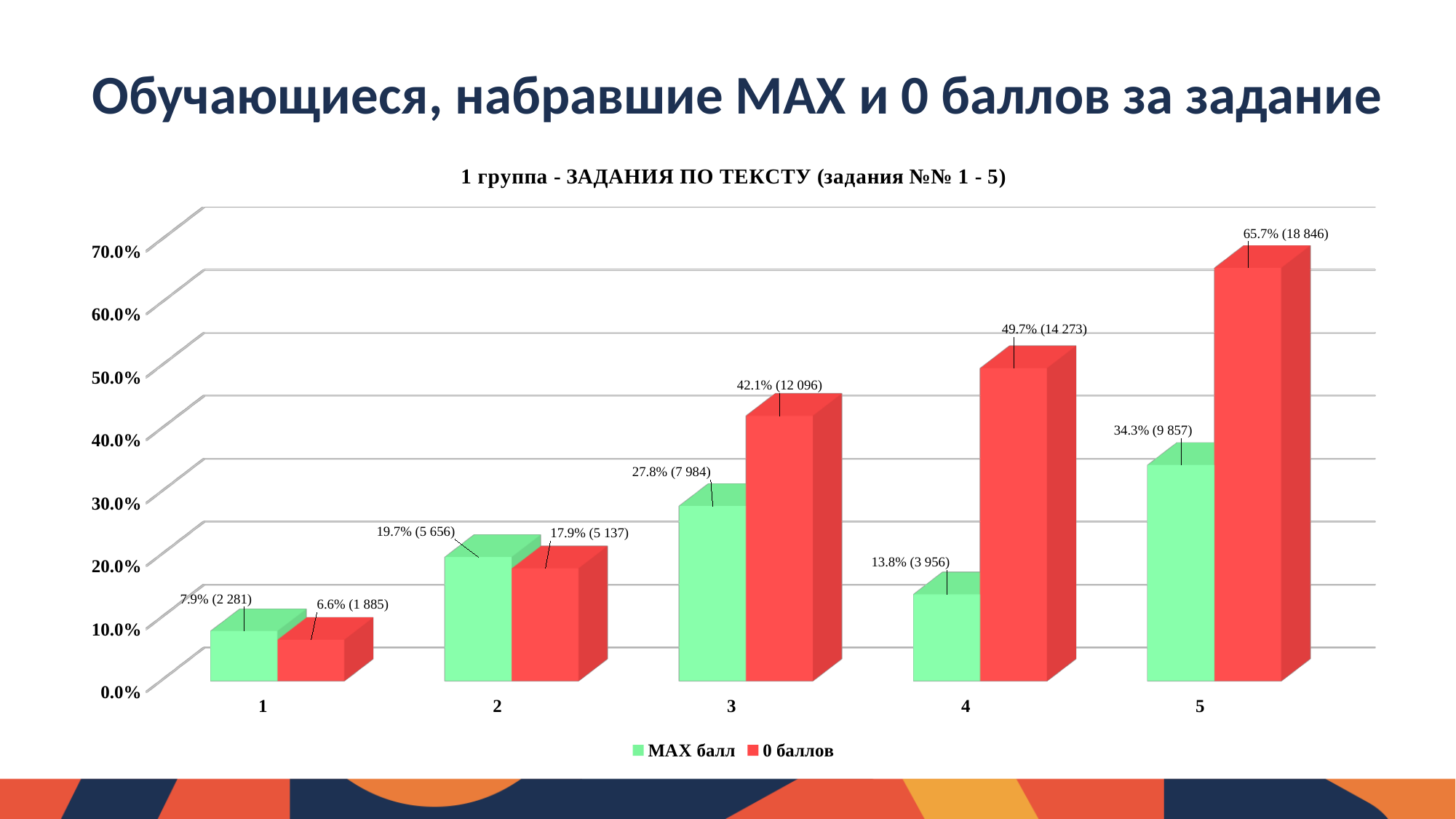
What is the percentage value for 'MAX балл' in category 3? 27.8% In category 2, which series has the larger value, 'MAX балл' or '0 баллов'? MAX балл What number of students is shown in parentheses for '0 баллов' in category 4? 14 273 What is the title of the chart? 1 группа - ЗАДАНИЯ ПО ТЕКСТУ (задания №№ 1 - 5) How many categories are shown on the x axis? 5 Which category has the lowest value for 'MAX балл'? 1 What is the difference in percentage points between '0 баллов' and 'MAX балл' in category 4? 35.9 Which category has the highest value for '0 баллов'? 5 Is the value for '0 баллов' in category 3 greater or less than 40.0%? greater How many series does the legend list? 2 What is the percentage value for '0 баллов' in category 5? 65.7% What type of chart is shown on the slide? bar chart